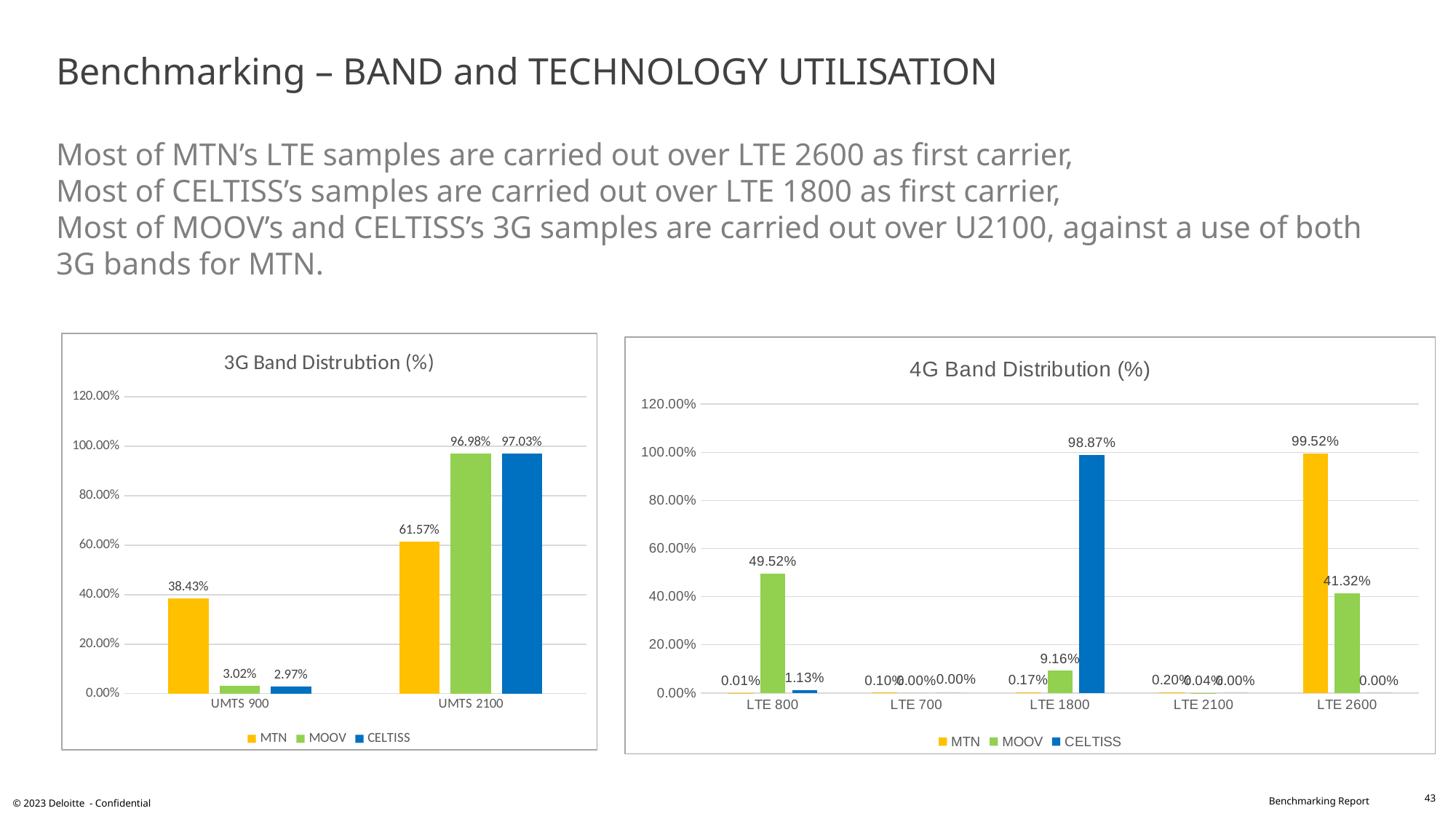
What kind of chart is the 4G Band Distribution (%) chart? Bar chart In the 3G Band Distrubtion (%) chart, what is the difference between MTN's values at UMTS 2100 and UMTS 900? 23.14% In the 4G Band Distribution (%) chart, how many bands are shown on the x axis? 5 In the 3G Band Distrubtion (%) chart, how many series does the legend list? 3 In the 4G Band Distribution (%) chart, what is the value for MOOV at LTE 800? 49.52% In the 4G Band Distribution (%) chart, which band has the highest value for MOOV? LTE 800 In the 4G Band Distribution (%) chart, is the value for MOOV at LTE 2600 greater or less than 40.00%? greater In the 3G Band Distrubtion (%) chart, which series has the highest value at UMTS 900? MTN In the 3G Band Distrubtion (%) chart, what is the value for MTN at UMTS 900? 38.43% In the 4G Band Distribution (%) chart, what is the value for MTN at LTE 2600? 99.52% In the 4G Band Distribution (%) chart, what is the value for CELTISS at LTE 1800? 98.87% In the 3G Band Distrubtion (%) chart, what is the value for CELTISS at UMTS 2100? 97.03%